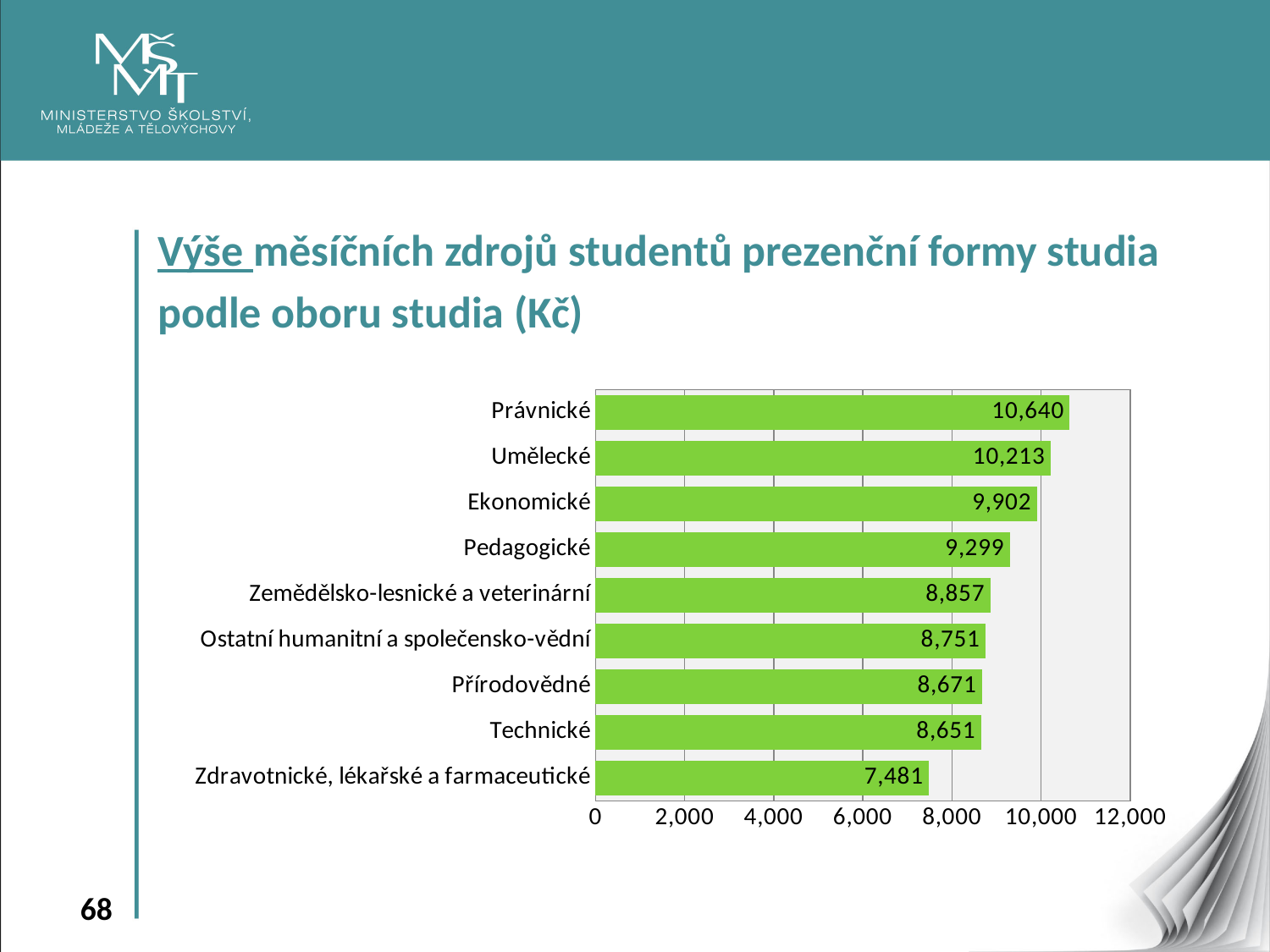
What is the value for Právnické? 10,640 How many categories are shown in the chart? 9 What is the value for Zdravotnické, lékařské a farmaceutické? 7,481 What is the value for Pedagogické? 9,299 What is the value for Přírodovědné? 8,671 Which category has the lowest value? Zdravotnické, lékařské a farmaceutické Is the value for Technické greater or less than 8,000? greater What is the difference between the values for Ekonomické and Zdravotnické, lékařské a farmaceutické? 2,421 What is the difference between the values for Právnické and Umělecké? 427 Which category has the highest value? Právnické Which is larger, the value for Ekonomické or the value for Pedagogické? Ekonomické What kind of chart is shown on the slide? Bar chart